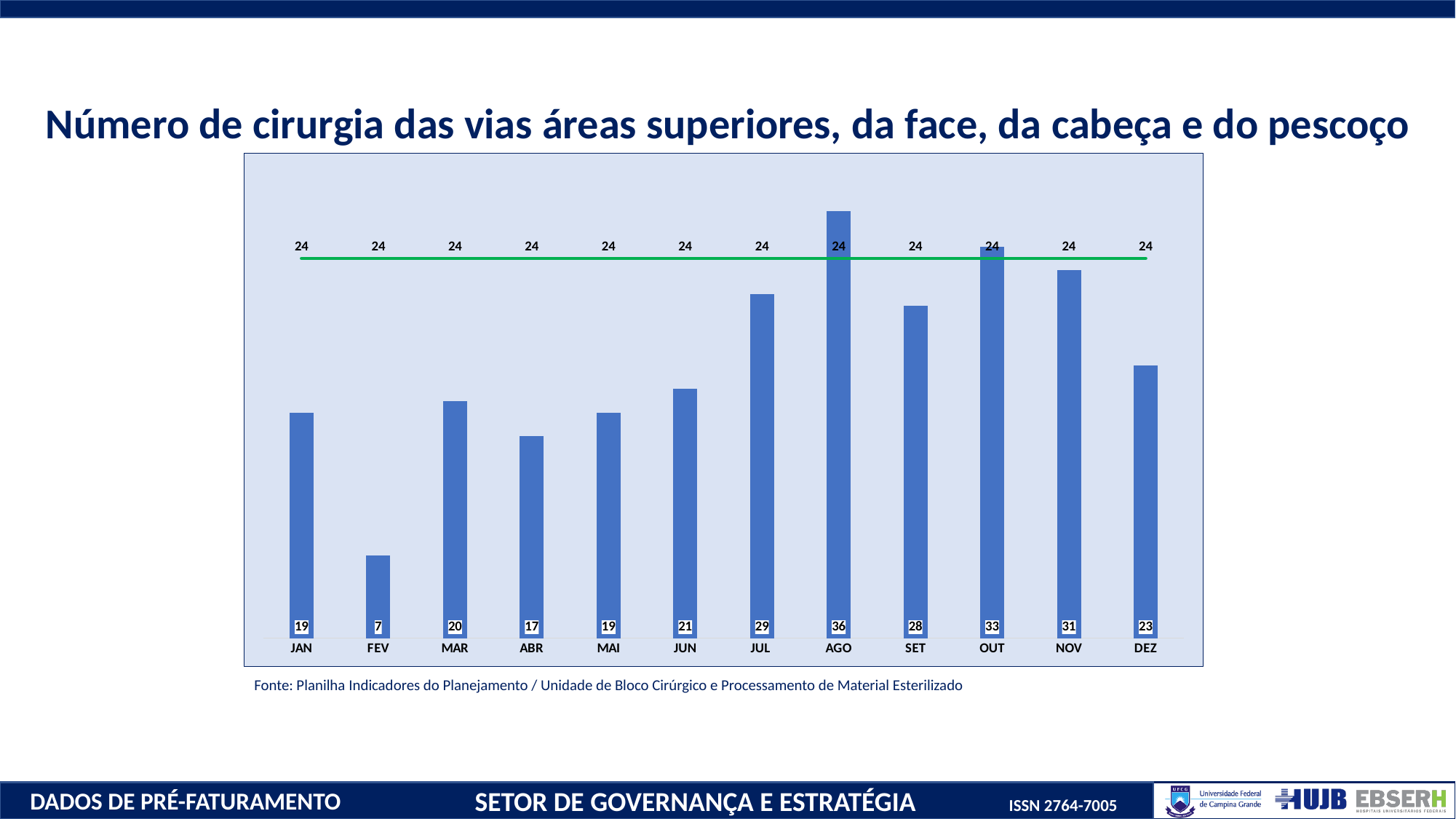
Which month has the highest number of surgeries? AGO Which month has more surgeries, JUL or SET? JUL What kind of chart is shown on the slide? Combination bar and line chart What is the difference between the number of surgeries in AGO and in FEV? 29 Do the number of surgeries rise or fall from JUN to AGO? Rise What is the title of the chart? Número de cirurgia das vias áreas superiores, da face, da cabeça e do pescoço What is the number of surgeries in AGO? 36 What is the value of the green target line in each month? 24 How many months are shown on the x axis? 12 What is the difference between the number of surgeries in OUT and the target value of 24? 9 Which month has the lowest number of surgeries? FEV What is the number of surgeries in FEV? 7